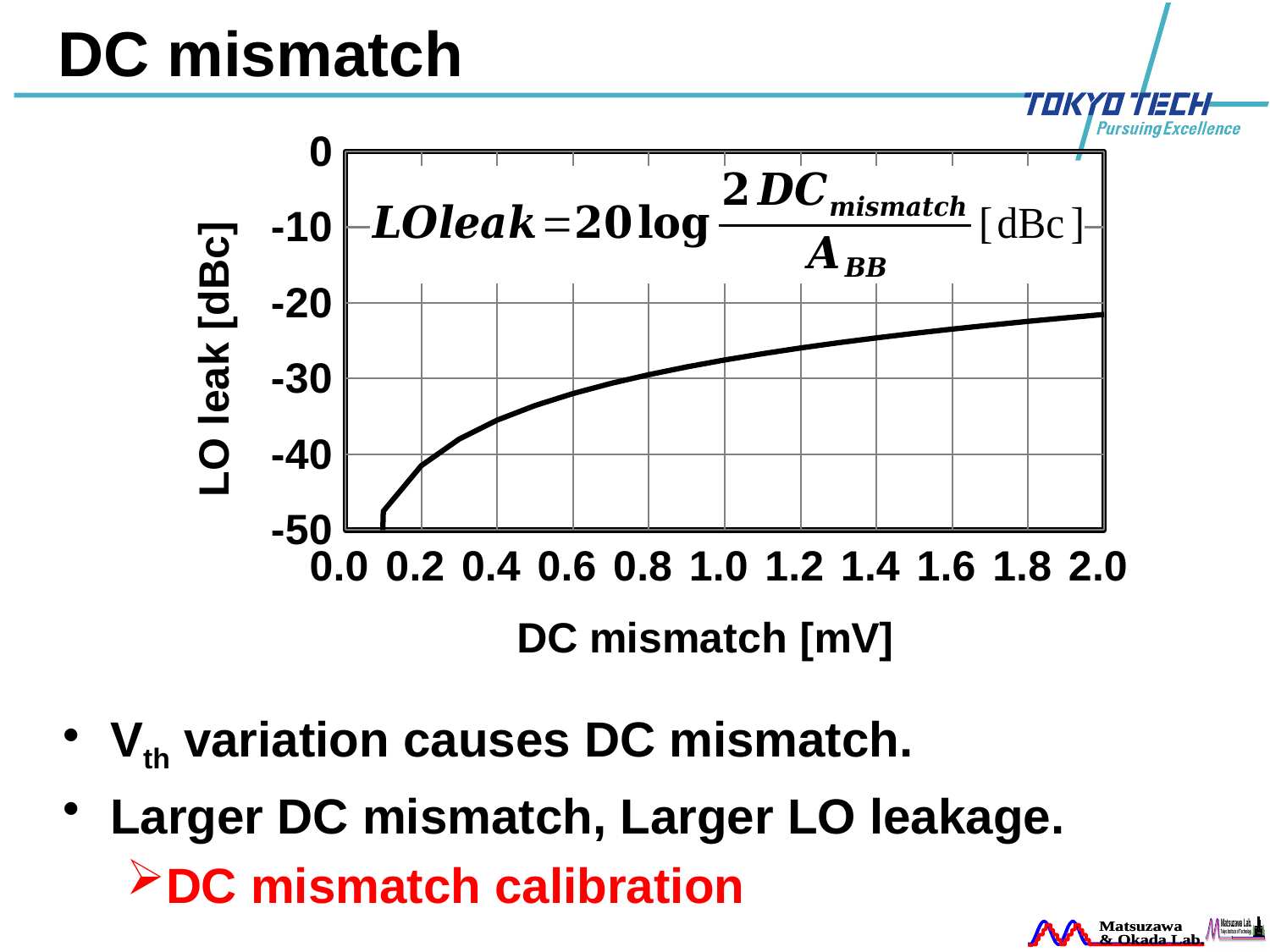
Does the LO leak rise or fall as DC mismatch increases along the x axis? rise Is the LO leak at a DC mismatch of 2.0 mV greater or less than -30 dBc? greater Is the LO leak at a DC mismatch of 0.4 mV greater or less than -30 dBc? less What kind of chart is shown on the slide? line chart Is the LO leak at a DC mismatch of 1.6 mV greater or less than -20 dBc? less What is the label of the x axis? DC mismatch [mV] Which DC mismatch value shown on the x axis gives the highest LO leak? 2.0 mV What is the label of the y axis? LO leak [dBc] Which is larger, the LO leak at 1.0 mV or at 0.4 mV of DC mismatch? 1.0 mV